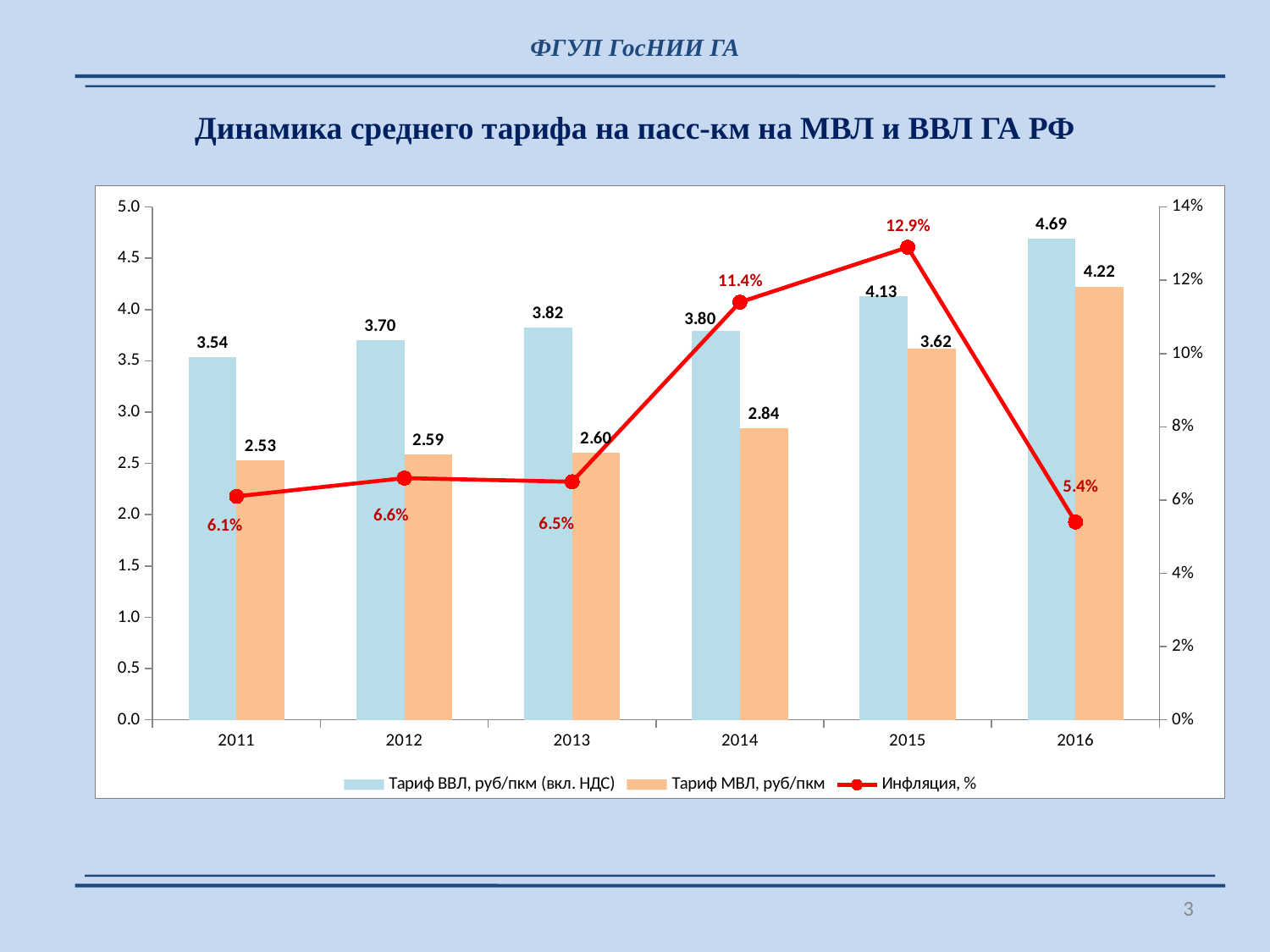
What kind of chart is this? Combined bar and line chart In which year is Тариф МВЛ, руб/пкм highest? 2016 In which year is Инфляция, % lowest? 2016 Which is larger in 2015: Тариф ВВЛ, руб/пкм (вкл. НДС) or Тариф МВЛ, руб/пкм? Тариф ВВЛ, руб/пкм (вкл. НДС) How many years are shown on the x axis? 6 What is the difference between Тариф ВВЛ, руб/пкм (вкл. НДС) and Тариф МВЛ, руб/пкм in 2011? 1.01 What is the Инфляция, % value for 2015? 12.9% How many series does the legend list? 3 Does Тариф ВВЛ, руб/пкм (вкл. НДС) generally rise or fall from 2011 to 2016? Rise What is the value of Тариф МВЛ, руб/пкм in 2013? 2.60 What is the title of the chart? Динамика среднего тарифа на пасс-км на МВЛ и ВВЛ ГА РФ What is the value of Тариф ВВЛ, руб/пкм (вкл. НДС) in 2014? 3.80